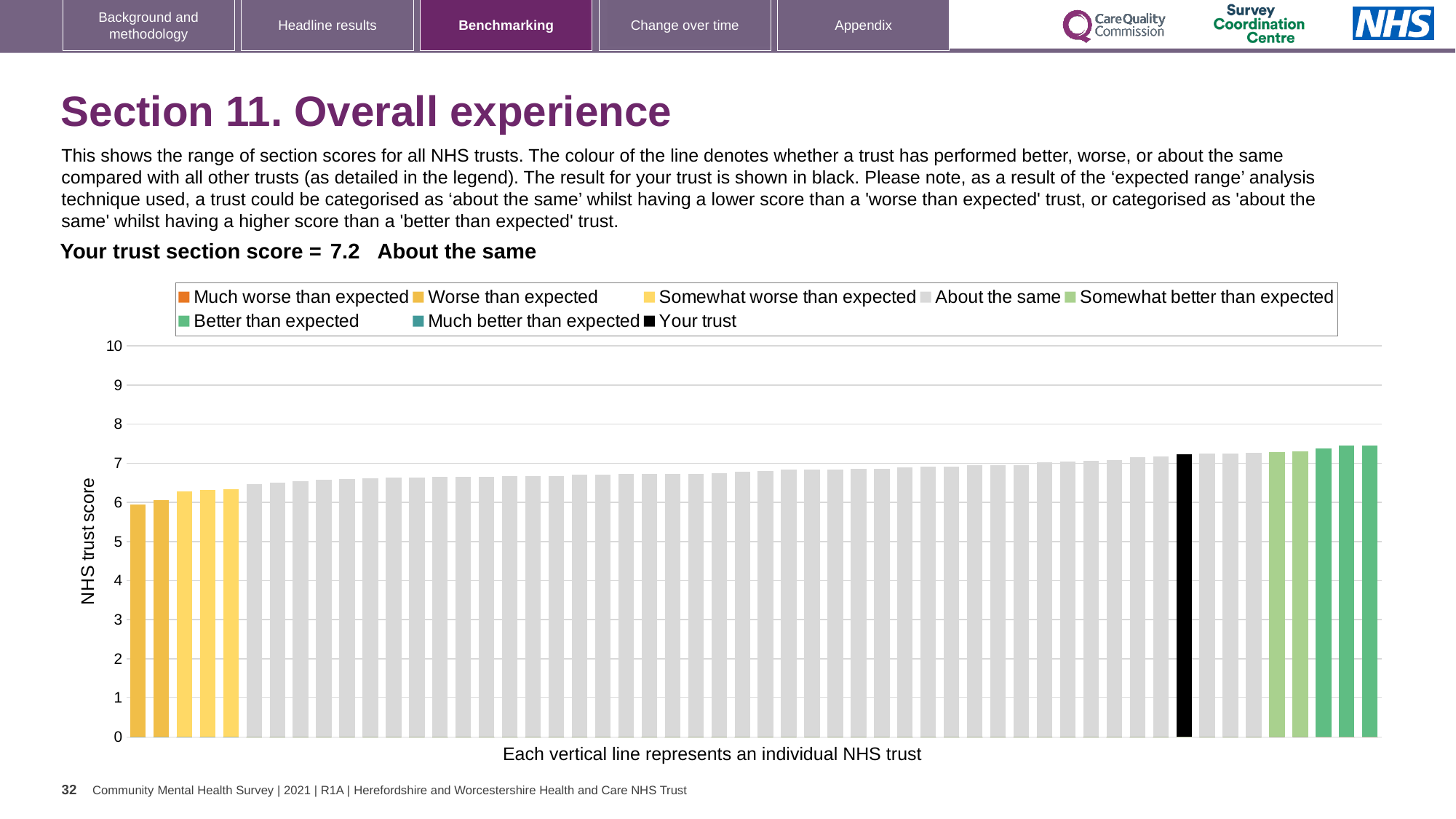
What does each vertical line in the chart represent, according to the x-axis label? an individual NHS trust How many entries does the chart legend list? 8 What is the highest value shown on the vertical axis? 10 What kind of chart is shown on the slide? bar chart Which performance category is your trust placed in for this section? About the same How many bars are coloured black in the chart? 1 What is the section score for your trust shown on the slide? 7.2 Is the value of the highest bar greater or less than 8? less Is the value of the highest bar greater or less than 7? greater Do the bar values rise or fall from left to right along the x axis? rise What is the label on the vertical axis of the chart? NHS trust score Is the value for your trust (the black bar) greater or less than 7? greater